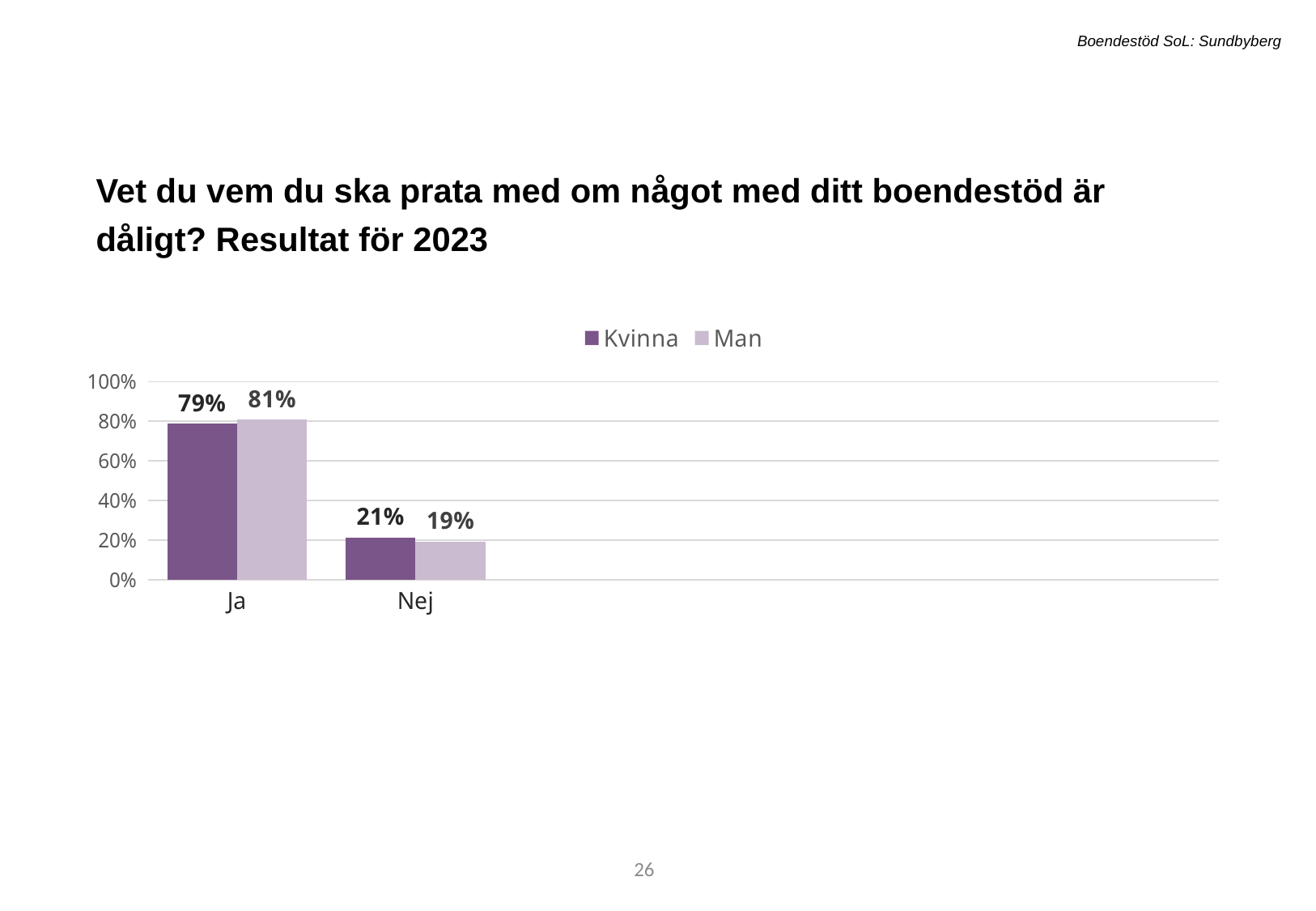
What percentage of Kvinna respondents answered Ja? 79% What percentage of Kvinna respondents answered Nej? 21% How many series does the legend list? 2 For Nej, which series has the larger value, Kvinna or Man? Kvinna What percentage of Man respondents answered Nej? 19% What kind of chart is shown on the slide? Bar chart What is the difference between the Kvinna values for Ja and Nej? 58% Which answer category has the lowest value for the Kvinna series? Nej What percentage of Man respondents answered Ja? 81% Which answer category has the highest value for the Man series? Ja What is the difference between the Man and Kvinna values for Ja? 2% How many answer categories are shown on the x axis? 2